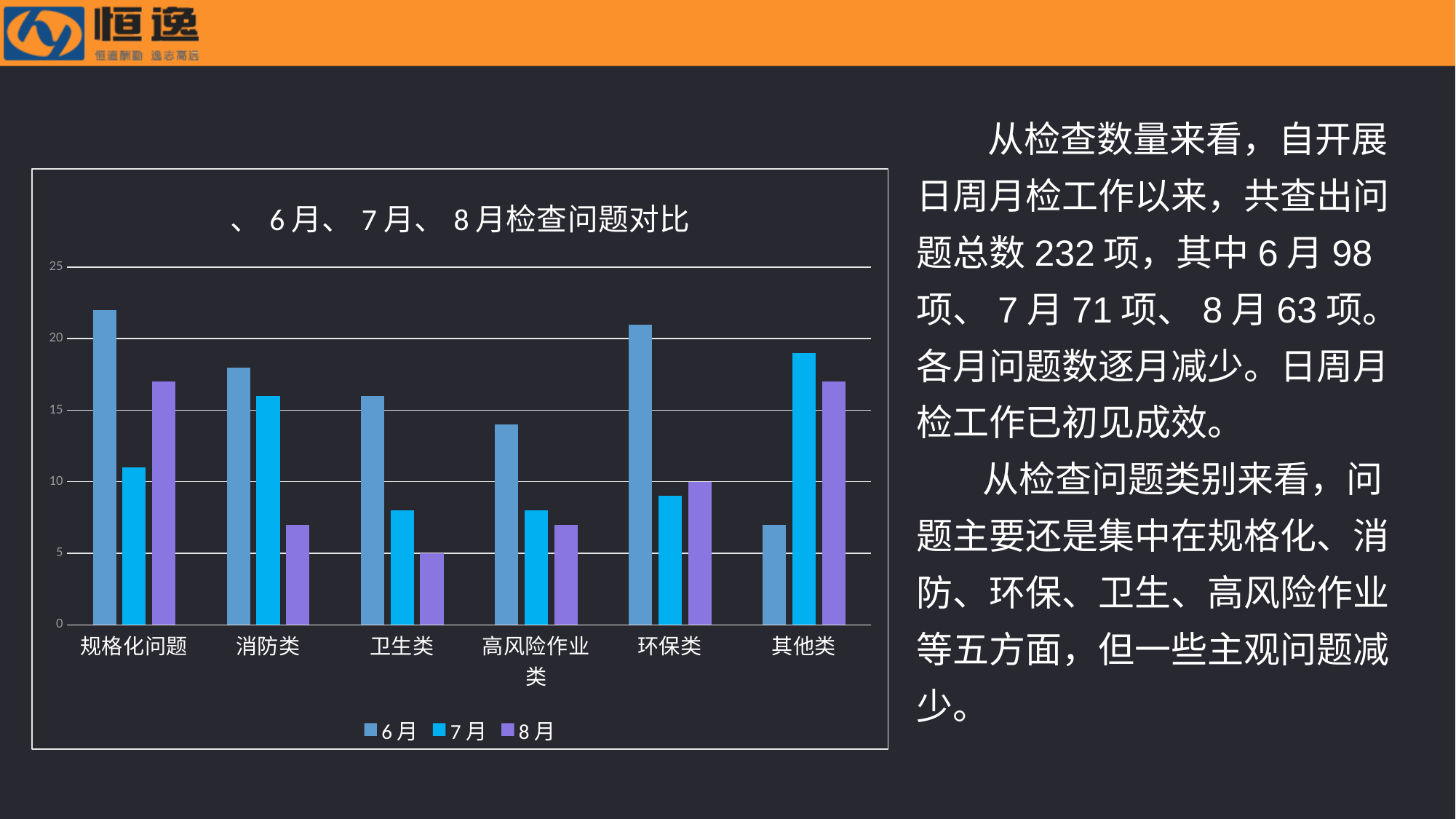
Is the value for 规格化问题 in the 6月 series greater or less than 20? greater How many series does the chart legend list? 3 What kind of chart is shown on the slide? bar chart Which series in the legend is shown in purple? 8月 Which category has the lowest value in the 8月 series? 卫生类 Is the value for 消防类 in the 8月 series greater or less than 10? less What is the value for 环保类 in the 8月 series? 10 What is the value for 卫生类 in the 8月 series? 5 Which category has the lowest value in the 6月 series? 其他类 How many categories are shown on the x axis of the chart? 6 For 规格化问题, which is larger: the 6月 value or the 7月 value? 6月 Which category has the highest value in the 7月 series? 其他类